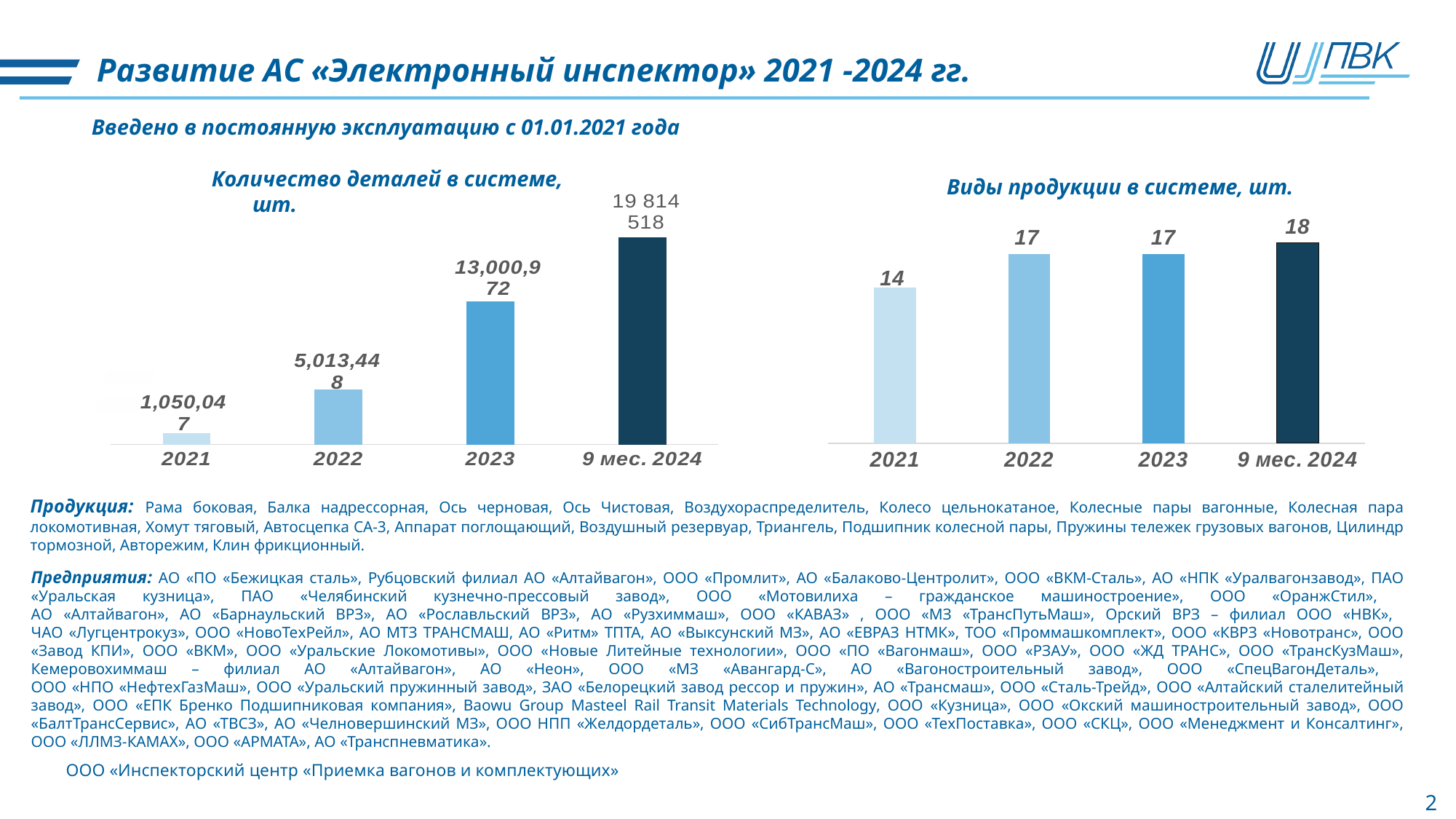
In the chart 'Виды продукции в системе, шт.', what is the difference between the values for 9 мес. 2024 and 2021? 4 In the chart 'Виды продукции в системе, шт.', which category has the lowest value? 2021 In the chart 'Количество деталей в системе, шт.', do the values rise or fall from 2021 to 9 мес. 2024? rise In the chart 'Виды продукции в системе, шт.', what is the value for 9 мес. 2024? 18 In the chart 'Количество деталей в системе, шт.', what is the value for 9 мес. 2024? 19 814 518 In the chart 'Количество деталей в системе, шт.', what is the value for 2022? 5,013,448 In the chart 'Количество деталей в системе, шт.', which category has the highest value? 9 мес. 2024 In the chart 'Количество деталей в системе, шт.', which is larger, the value for 2023 or the value for 2022? 2023 In the chart 'Виды продукции в системе, шт.', what is the value for 2021? 14 What type of chart is 'Количество деталей в системе, шт.'? bar chart How many categories are shown on the x axis of the chart 'Виды продукции в системе, шт.'? 4 In the chart 'Виды продукции в системе, шт.', what is the difference between the values for 2022 and 2021? 3